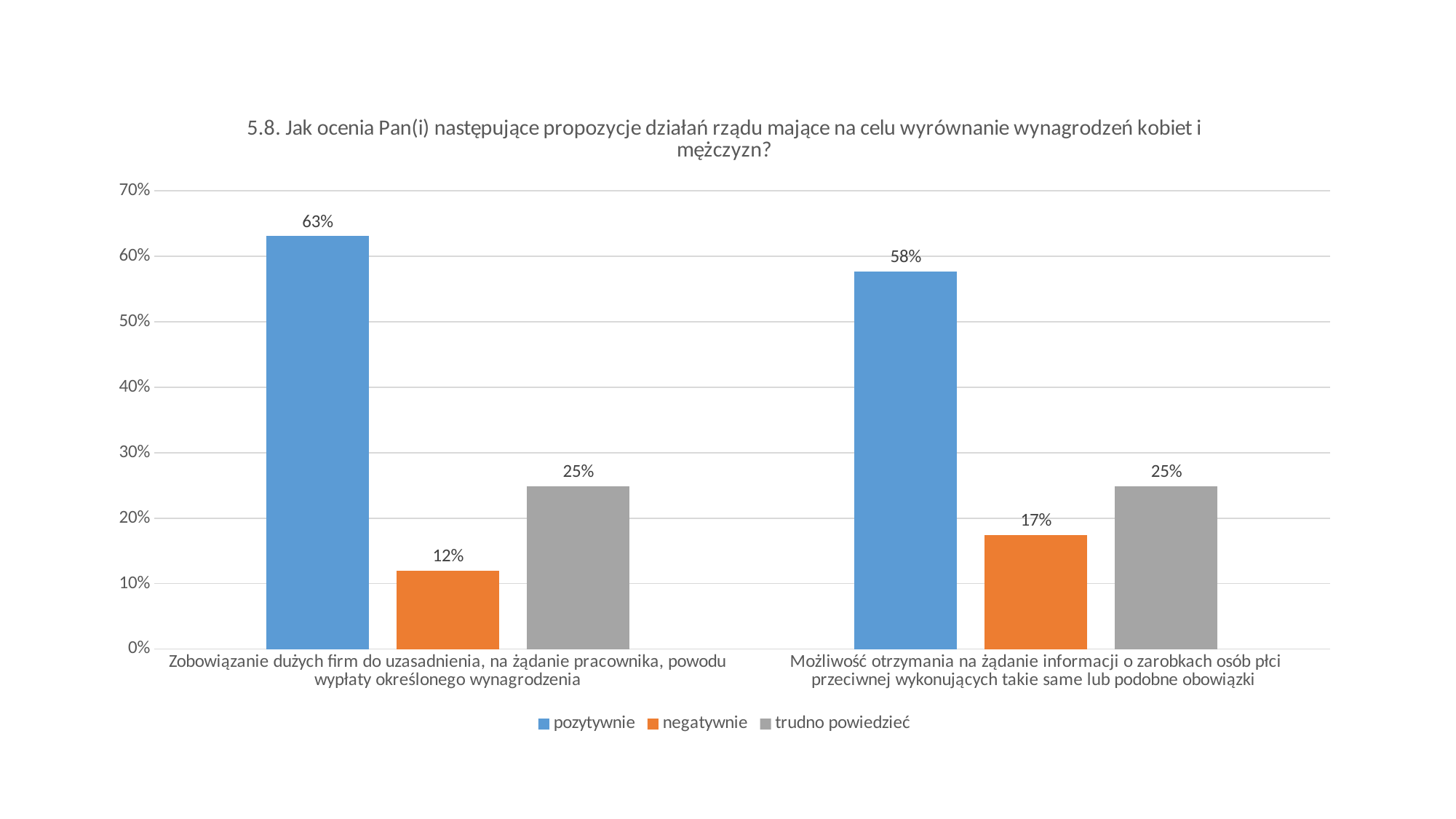
Which series has the highest value for the category "Możliwość otrzymania na żądanie informacji o zarobkach osób płci przeciwnej wykonujących takie same lub podobne obowiązki"? pozytywnie What is the value for "trudno powiedzieć" for the category "Zobowiązanie dużych firm do uzasadnienia, na żądanie pracownika, powodu wypłaty określonego wynagrodzenia"? 25% What kind of chart is shown on the slide? bar chart Which category has the larger "pozytywnie" value? Zobowiązanie dużych firm do uzasadnienia, na żądanie pracownika, powodu wypłaty określonego wynagrodzenia What is the difference between the "pozytywnie" values of the two categories? 5% What is the difference between the "negatywnie" values of the two categories? 5% What is the value for "pozytywnie" for the category "Zobowiązanie dużych firm do uzasadnienia, na żądanie pracownika, powodu wypłaty określonego wynagrodzenia"? 63% Is the "pozytywnie" value for "Możliwość otrzymania na żądanie informacji o zarobkach osób płci przeciwnej wykonujących takie same lub podobne obowiązki" greater or less than 50%? greater How many categories are shown on the x axis? 2 What is the value for "negatywnie" for the category "Możliwość otrzymania na żądanie informacji o zarobkach osób płci przeciwnej wykonujących takie same lub podobne obowiązki"? 17% How many series does the legend list? 3 Which series has the lowest value for the category "Zobowiązanie dużych firm do uzasadnienia, na żądanie pracownika, powodu wypłaty określonego wynagrodzenia"? negatywnie